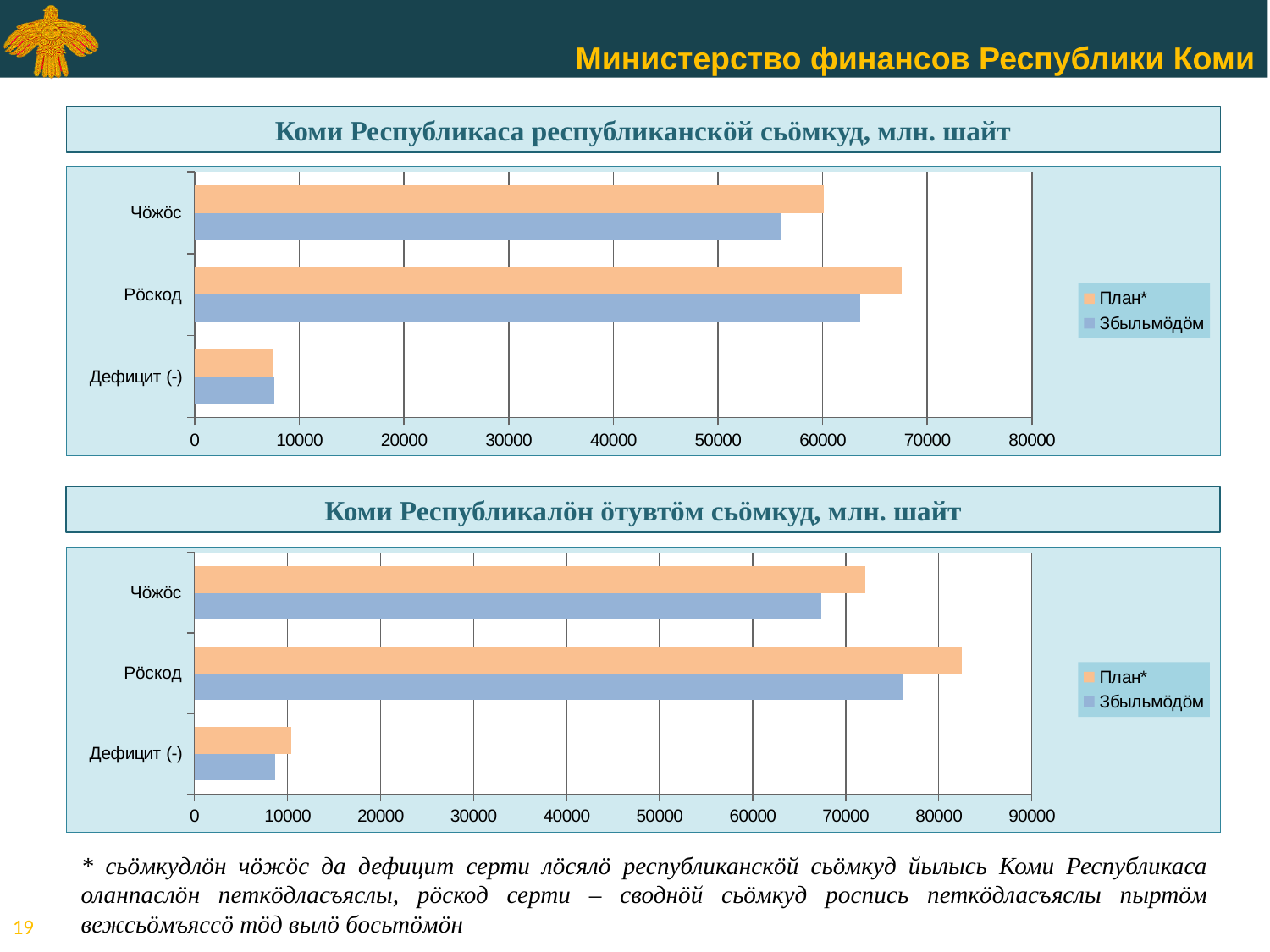
In the top chart, 'Коми Республикаса республиканскöй сьöмкуд, млн. шайт', what kind of chart is shown? bar chart In the top chart, 'Коми Республикаса республиканскöй сьöмкуд, млн. шайт', how many categories are shown on the vertical axis? 3 In the bottom chart, 'Коми Республикалöн öтувтöм сьöмкуд, млн. шайт', is the План* value for Рöскод greater or less than 80000? greater In the bottom chart, 'Коми Республикалöн öтувтöм сьöмкуд, млн. шайт', which is larger for Дефицит (-): План* or Збыльмöдöм? План* In the bottom chart, 'Коми Республикалöн öтувтöм сьöмкуд, млн. шайт', what is the highest value shown on the horizontal axis? 90000 In the top chart, 'Коми Республикаса республиканскöй сьöмкуд, млн. шайт', how many series does the legend list? 2 In the bottom chart, 'Коми Республикалöн öтувтöм сьöмкуд, млн. шайт', which category has the highest План* value? Рöскод In the top chart, 'Коми Республикаса республиканскöй сьöмкуд, млн. шайт', which category has the highest План* value? Рöскод In the top chart, 'Коми Республикаса республиканскöй сьöмкуд, млн. шайт', which is larger for Чöжöс: План* or Збыльмöдöм? План* In the top chart, 'Коми Республикаса республиканскöй сьöмкуд, млн. шайт', which category has the lowest Збыльмöдöм value? Дефицит (-) In the top chart, 'Коми Республикаса республиканскöй сьöмкуд, млн. шайт', is the План* value for Рöскод greater or less than 60000? greater In the top chart, 'Коми Республикаса республиканскöй сьöмкуд, млн. шайт', is the Збыльмöдöм value for Чöжöс greater or less than 60000? less